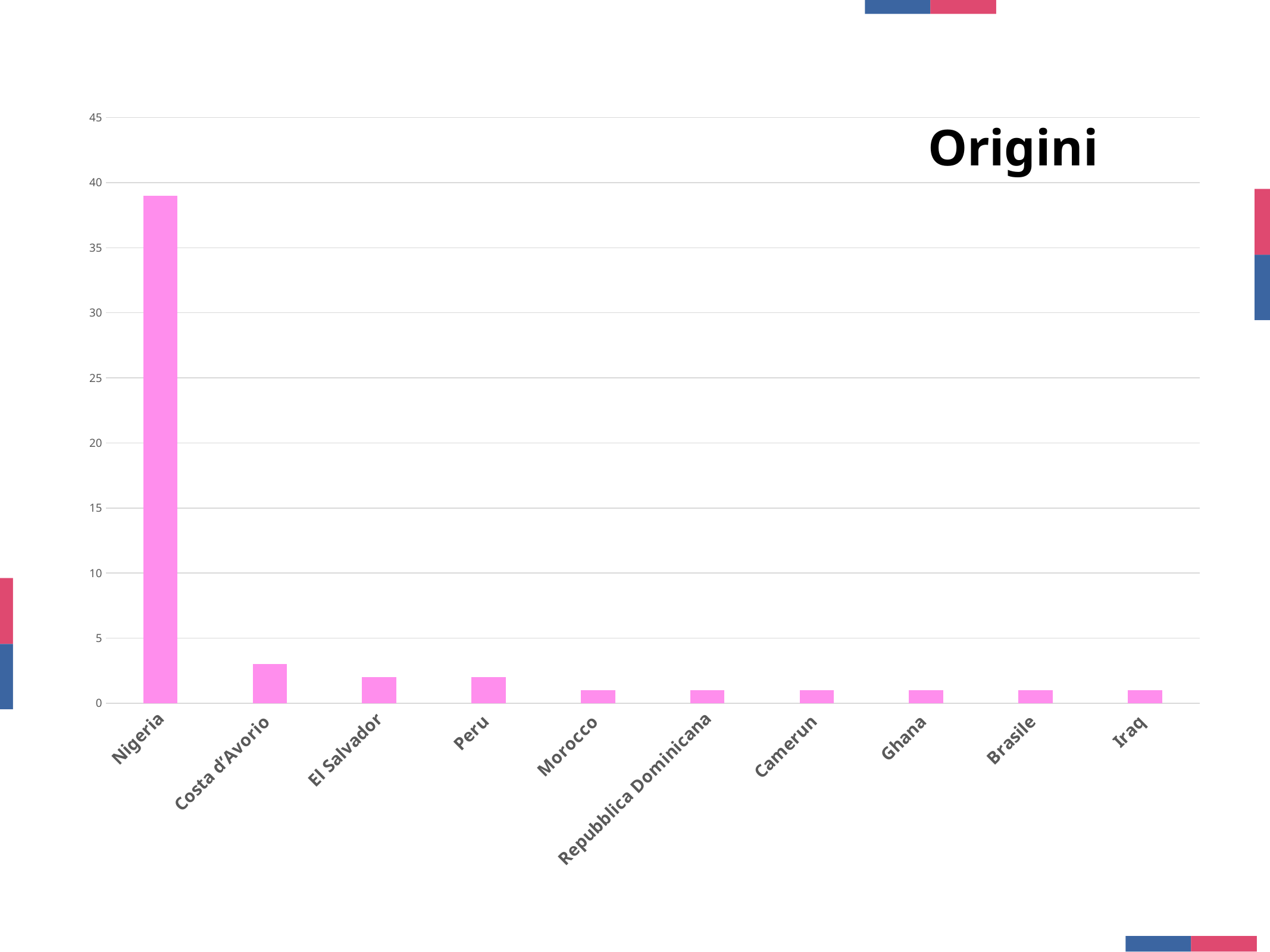
Which category has the highest value in the chart? Nigeria Is the value for Nigeria greater or less than 35? greater Which is larger, the value for Costa d'Avorio or the value for El Salvador? Costa d'Avorio Is the value for Iraq greater or less than 5? less What kind of chart is shown on the slide? bar chart Is the value for Costa d'Avorio greater or less than 5? less Which is larger, the value for Nigeria or the value for Costa d'Avorio? Nigeria How many categories are shown on the x axis of the chart? 10 What colour are the bars in the chart? pink Do the values generally rise or fall moving from left to right along the x axis? fall What is the title of the chart? Origini